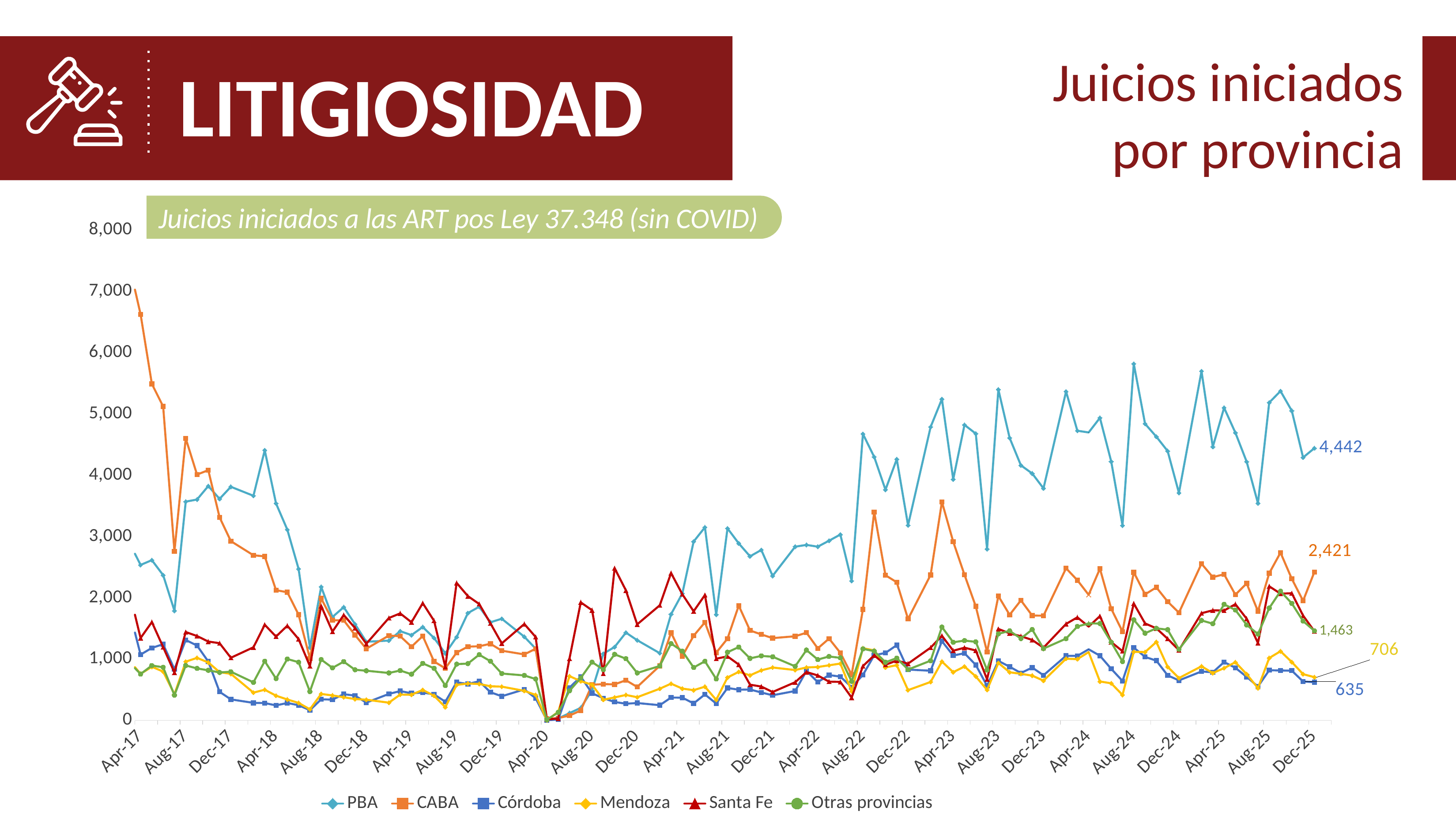
What is the value for Otras provincias at Dec-25? 1,463 What is the value for PBA at Dec-25? 4,442 Which series has the highest value at Dec-25? PBA How many series does the legend list? 6 Is the value for CABA at Apr-17 greater or less than 6,000? greater What is the value for Córdoba at Dec-25? 635 What is the title of the chart? Juicios iniciados a las ART pos Ley 37.348 (sin COVID) What is the value for Mendoza at Dec-25? 706 At Dec-25, which is larger: Mendoza or Córdoba? Mendoza What kind of chart is shown on the slide? line chart What is the difference between the PBA and CABA values at Dec-25? 2,021 What is the value for CABA at Dec-25? 2,421